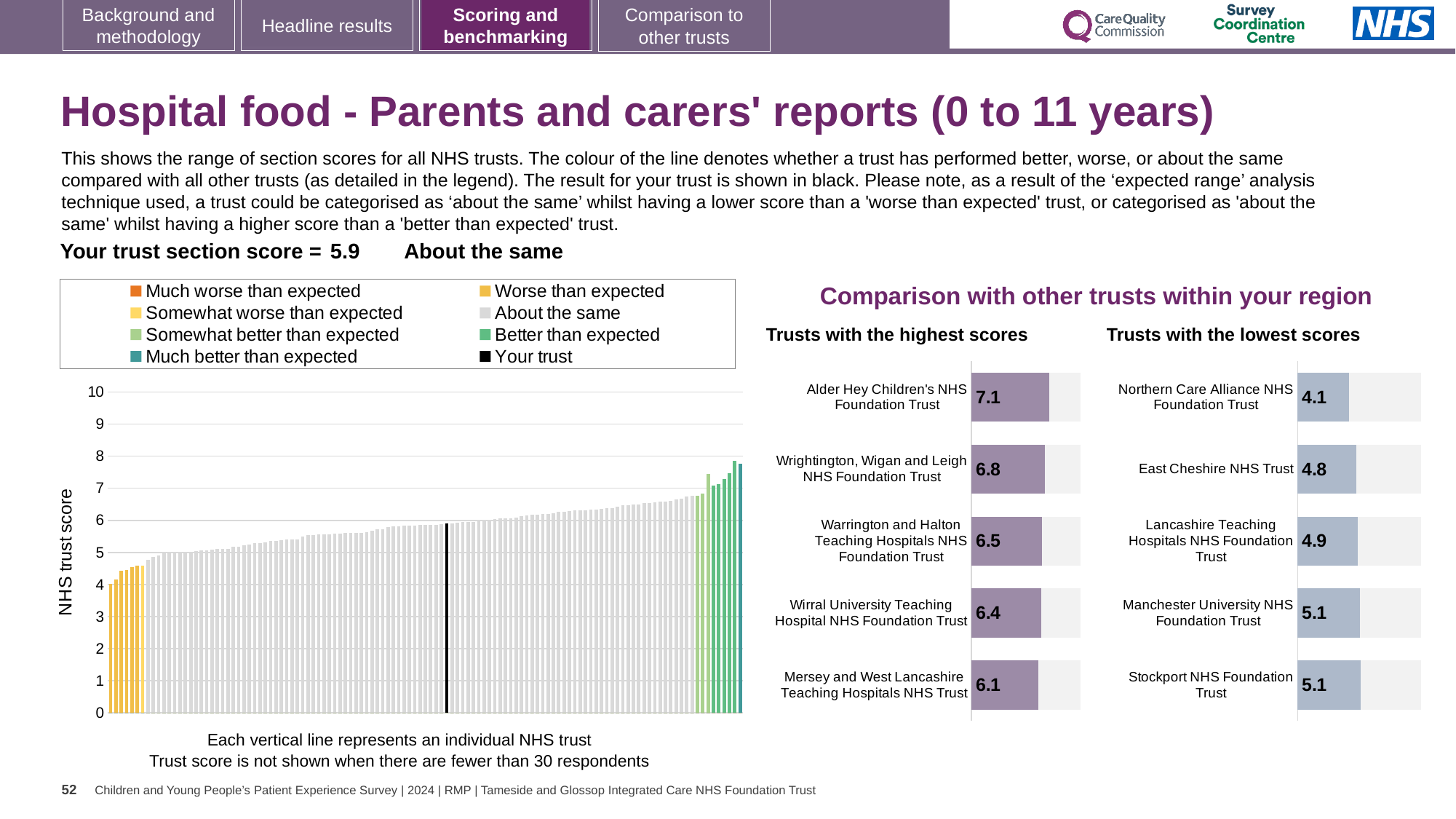
In the 'Trusts with the lowest scores' chart, what is the score for Lancashire Teaching Hospitals NHS Foundation Trust? 4.9 In the 'Trusts with the highest scores' chart, what is the difference between the scores of Alder Hey Children's NHS Foundation Trust and Mersey and West Lancashire Teaching Hospitals NHS Trust? 1.0 What type of chart is the 'NHS trust score' chart on the left of the slide? Bar chart In the 'Trusts with the lowest scores' chart, which trust has the lowest score? Northern Care Alliance NHS Foundation Trust In the 'Trusts with the lowest scores' chart, what is the score for Northern Care Alliance NHS Foundation Trust? 4.1 In the 'Trusts with the highest scores' chart, which has the higher score: Wrightington, Wigan and Leigh NHS Foundation Trust or Warrington and Halton Teaching Hospitals NHS Foundation Trust? Wrightington, Wigan and Leigh NHS Foundation Trust In the 'Trusts with the highest scores' chart, what is the score for Wirral University Teaching Hospital NHS Foundation Trust? 6.4 In the 'Trusts with the highest scores' chart, what is the score for Alder Hey Children's NHS Foundation Trust? 7.1 In the 'NHS trust score' chart on the left, do the trust scores rise or fall from left to right? Rise How many trusts are shown in the 'Trusts with the lowest scores' chart? 5 In the 'Trusts with the lowest scores' chart, how much higher is East Cheshire NHS Trust's score than Northern Care Alliance NHS Foundation Trust's score? 0.7 In the 'Trusts with the highest scores' chart, which trust has the highest score? Alder Hey Children's NHS Foundation Trust